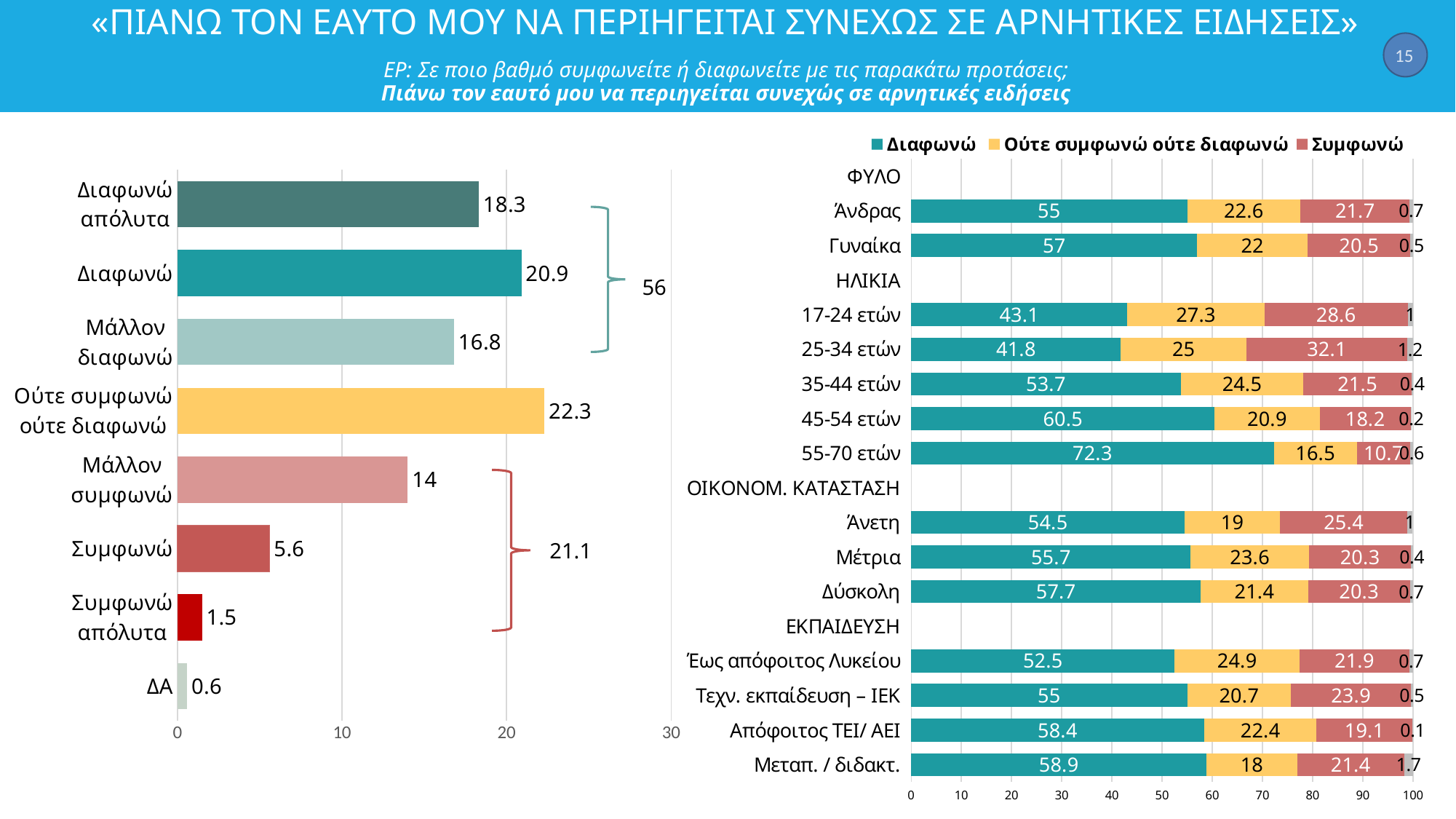
On the right stacked bar chart, is the «Διαφωνώ» value for Άνδρας or for Γυναίκα larger? Γυναίκα What kind of chart is the chart on the left of the slide? Bar chart On the right stacked bar chart, which age group has the highest «Διαφωνώ» value? 55-70 ετών On the left bar chart, what is the difference between the values for «Διαφωνώ» and «Συμφωνώ»? 15.3 On the left bar chart, which category has the highest value? Ούτε συμφωνώ ούτε διαφωνώ On the left bar chart, which category has the lowest value? ΔΑ How many series does the legend of the right stacked bar chart list? 3 On the right stacked bar chart, what is the «Διαφωνώ» value for 55-70 ετών? 72.3 On the left bar chart, how many categories are shown? 8 On the left bar chart, what is the value for «Ούτε συμφωνώ ούτε διαφωνώ»? 22.3 On the right stacked bar chart, what is the «Συμφωνώ» value for 25-34 ετών? 32.1 On the left bar chart, what total is shown by the bracket grouping the three «διαφωνώ» categories? 56